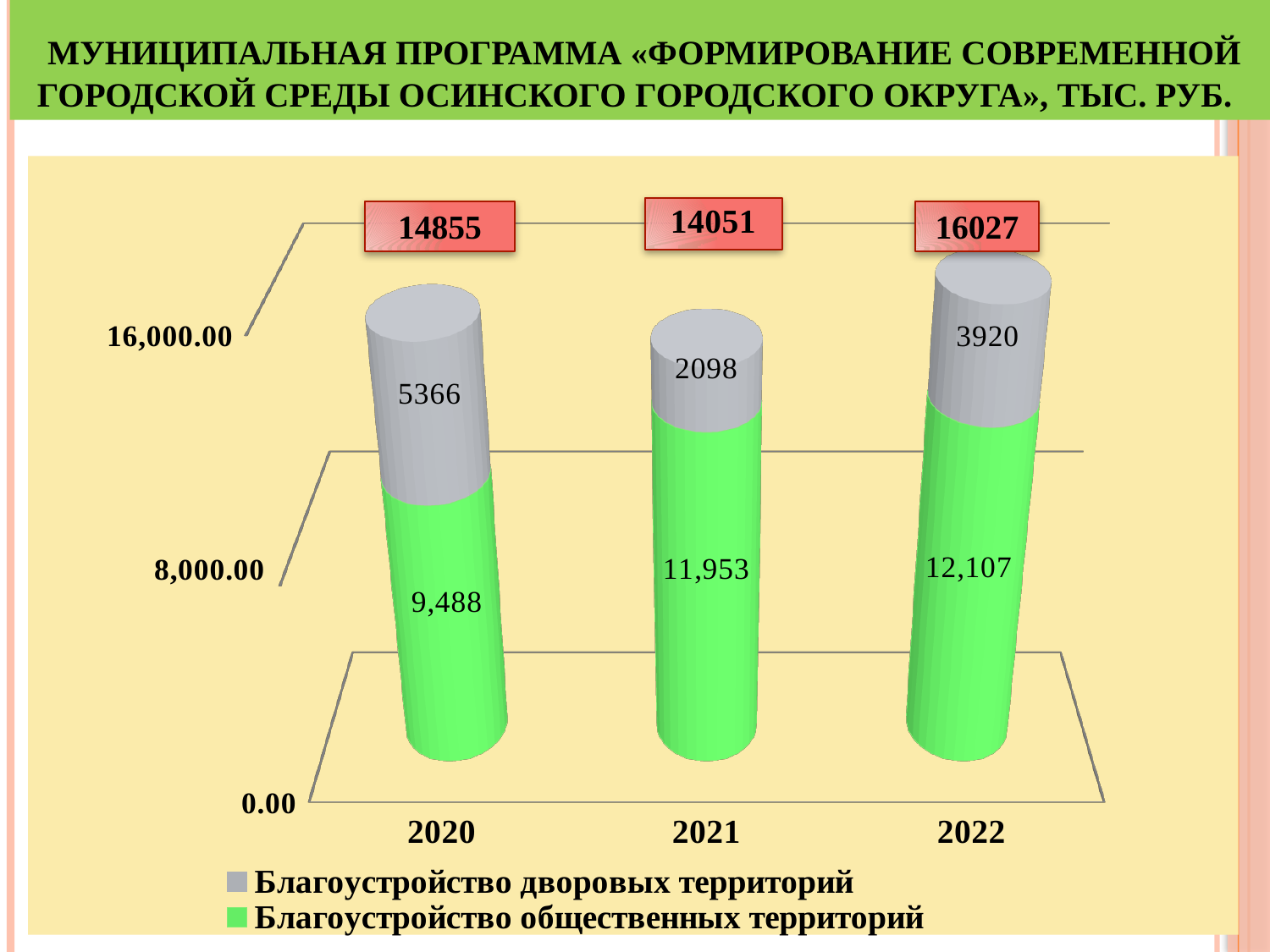
What is the value for "Благоустройство общественных территорий" in 2021? 11,953 How many years are shown on the x axis? 3 What is the total shown above the bar for 2021? 14051 What is the difference between the "Благоустройство дворовых территорий" values for 2022 and 2021? 1822 Which year has the lowest value for "Благоустройство дворовых территорий"? 2021 How many series does the legend list? 2 Which year has the highest value for "Благоустройство дворовых территорий"? 2020 What is the value for "Благоустройство дворовых территорий" in 2020? 5366 What is the total shown above the bar for 2022? 16027 Which is larger: "Благоустройство общественных территорий" in 2020 or in 2022? 2022 What is the value for "Благоустройство общественных территорий" in 2020? 9,488 What is the value for "Благоустройство дворовых территорий" in 2022? 3920